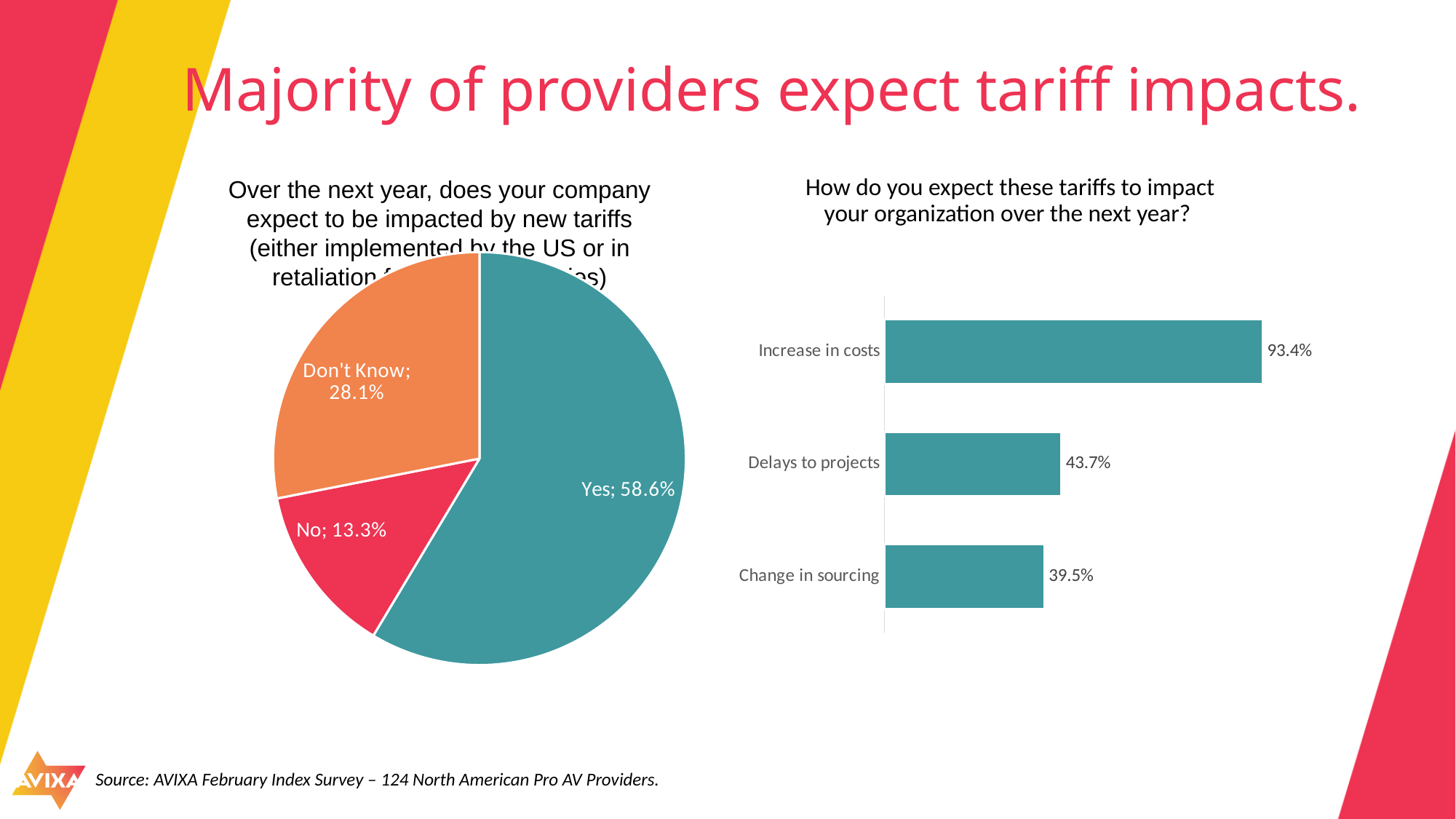
In the pie chart on the left, what share of providers answered "No"? 13.3% What kind of chart is shown on the right side of the slide? Bar chart In the pie chart on the left, what share of providers answered "Don't Know"? 28.1% In the pie chart on the left, how many slices are there? 3 In the bar chart on the right, what is the difference between "Increase in costs" and "Delays to projects"? 49.7% In the bar chart on the right, what is the value for "Change in sourcing"? 39.5% In the bar chart on the right, what is the value for "Increase in costs"? 93.4% In the pie chart on the left, which response has the smallest slice? No In the bar chart on the right, which is larger: "Delays to projects" or "Change in sourcing"? Delays to projects In the bar chart on the right, which category has the highest value? Increase in costs In the pie chart on the left, which response has the largest slice? Yes In the pie chart on the left, what share of providers answered "Yes"? 58.6%